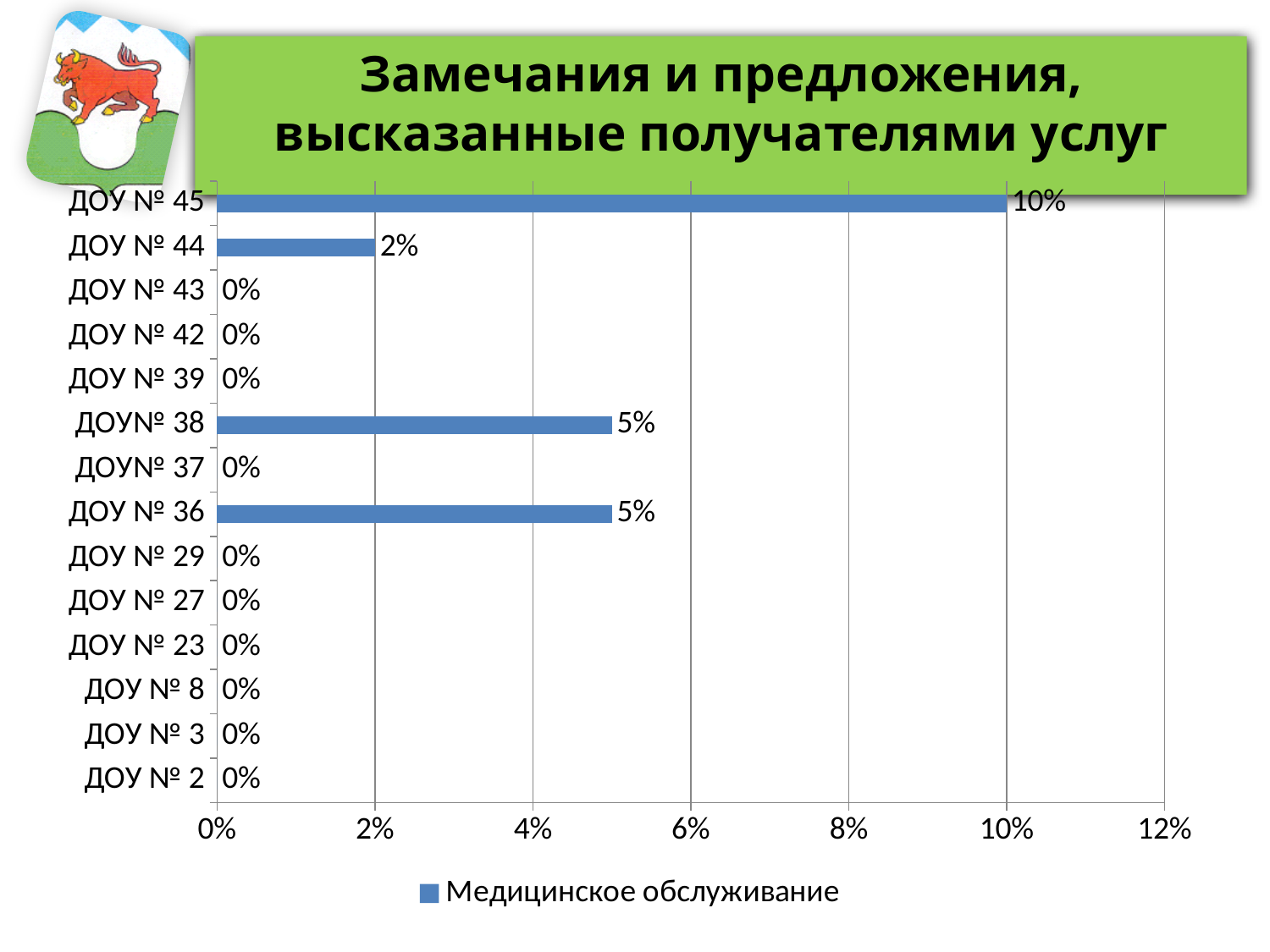
What is the difference between the values for ДОУ № 36 and ДОУ № 44? 3% Is the value for ДОУ № 45 greater or less than 8%? greater What is the value for ДОУ № 45? 10% What is the value for ДОУ № 38? 5% What is the value for ДОУ № 43? 0% What is the value for ДОУ № 44? 2% How many categories are shown on the chart? 14 What kind of chart is shown on the slide? bar chart Which is larger, the value for ДОУ № 38 or the value for ДОУ № 44? ДОУ № 38 What is the difference between the values for ДОУ № 45 and ДОУ № 44? 8% Which category has the highest value? ДОУ № 45 What series does the legend list? Медицинское обслуживание